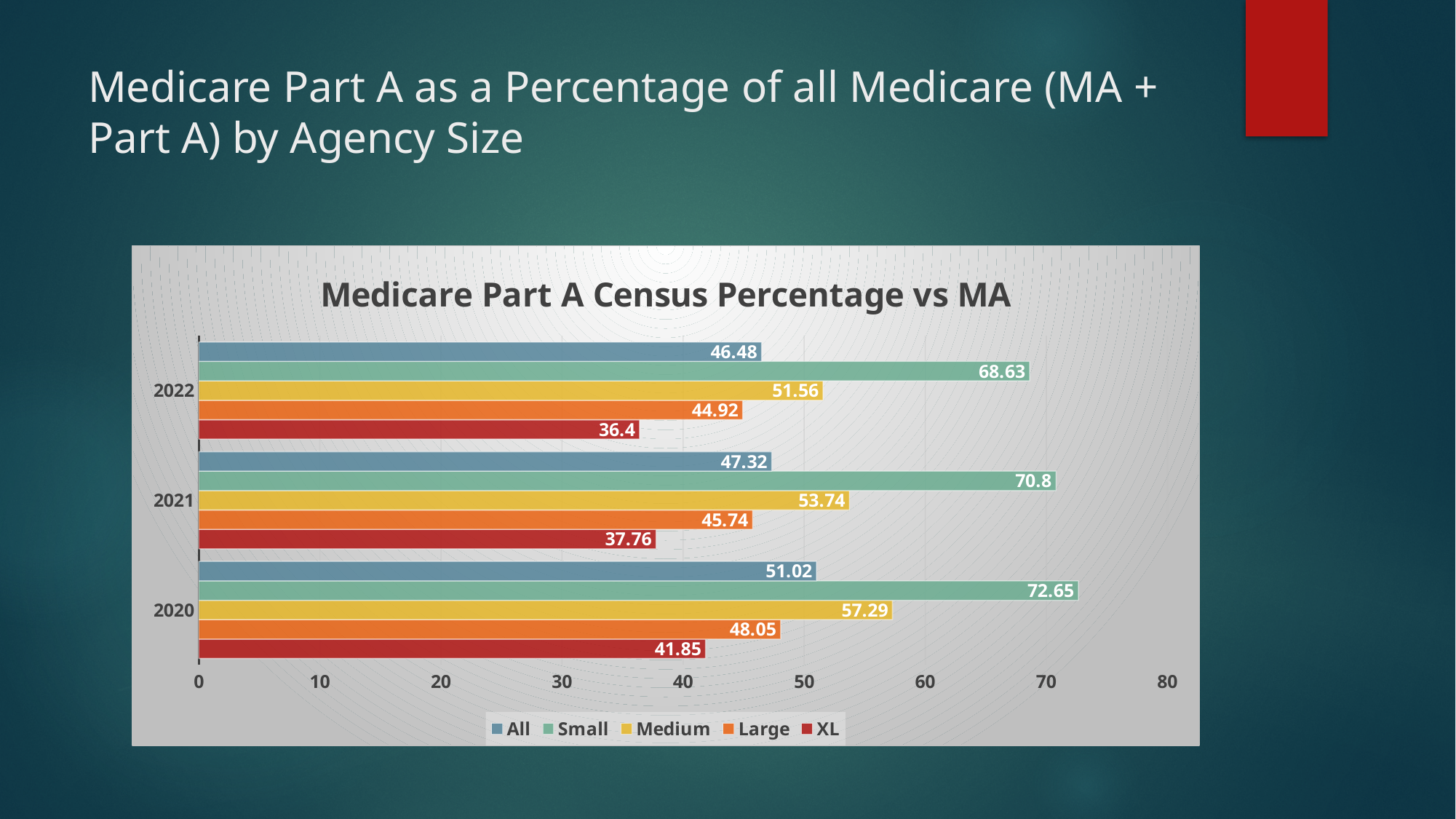
Which is larger, the Large value in 2020 or the Large value in 2022? Large value in 2020 How many years are shown on the y axis? 3 Which agency size has the lowest value in 2022? XL Which agency size has the highest value in 2020? Small What is the difference between the Small and XL values in 2021? 33.04 How many series does the legend list? 5 What is the value for XL in 2020? 41.85 What is the title of the chart? Medicare Part A Census Percentage vs MA What kind of chart is shown? bar chart What is the value for Medium in 2021? 53.74 What is the value for Small in 2022? 68.63 Is the value for All in 2022 greater or less than 50? less